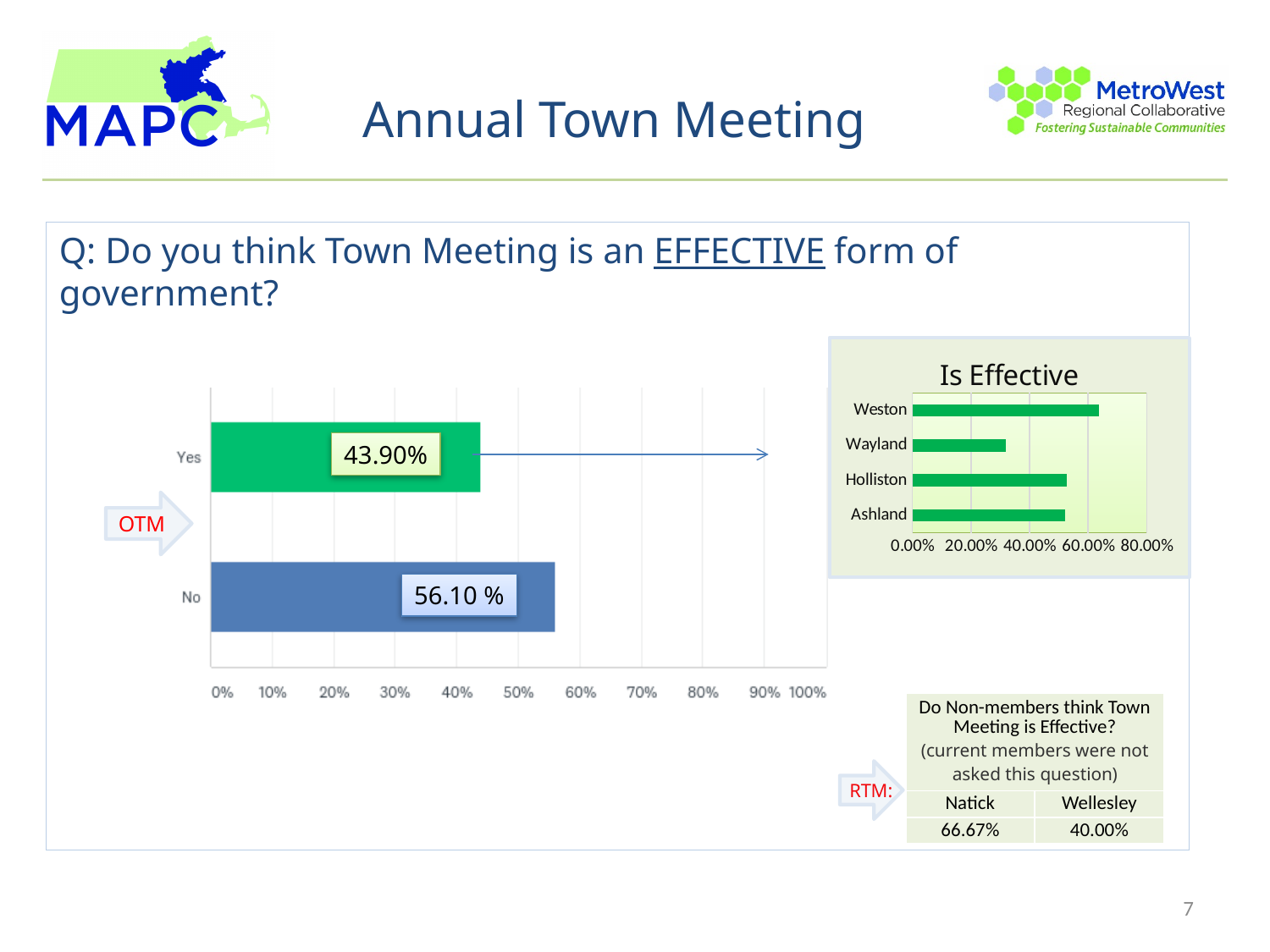
In the large OTM bar chart, is the value for Yes greater or less than 50%? less In the large OTM bar chart, what is the value for No? 56.10 % In the 'Is Effective' chart, is the value for Wayland greater or less than 40.00%? less How many towns are shown in the 'Is Effective' chart? 4 In the large OTM bar chart, what is the difference between the No and Yes values? 12.20% What kind of chart is the large OTM chart on the left? Bar chart In the large OTM bar chart, which category has the higher value, Yes or No? No In the large OTM bar chart, how many categories are shown? 2 In the 'Is Effective' chart, which town has the lowest value? Wayland In the large OTM bar chart, what is the value for Yes? 43.90% In the 'Is Effective' chart, is the value for Holliston greater or less than 40.00%? greater In the 'Is Effective' chart, which town has the highest value? Weston